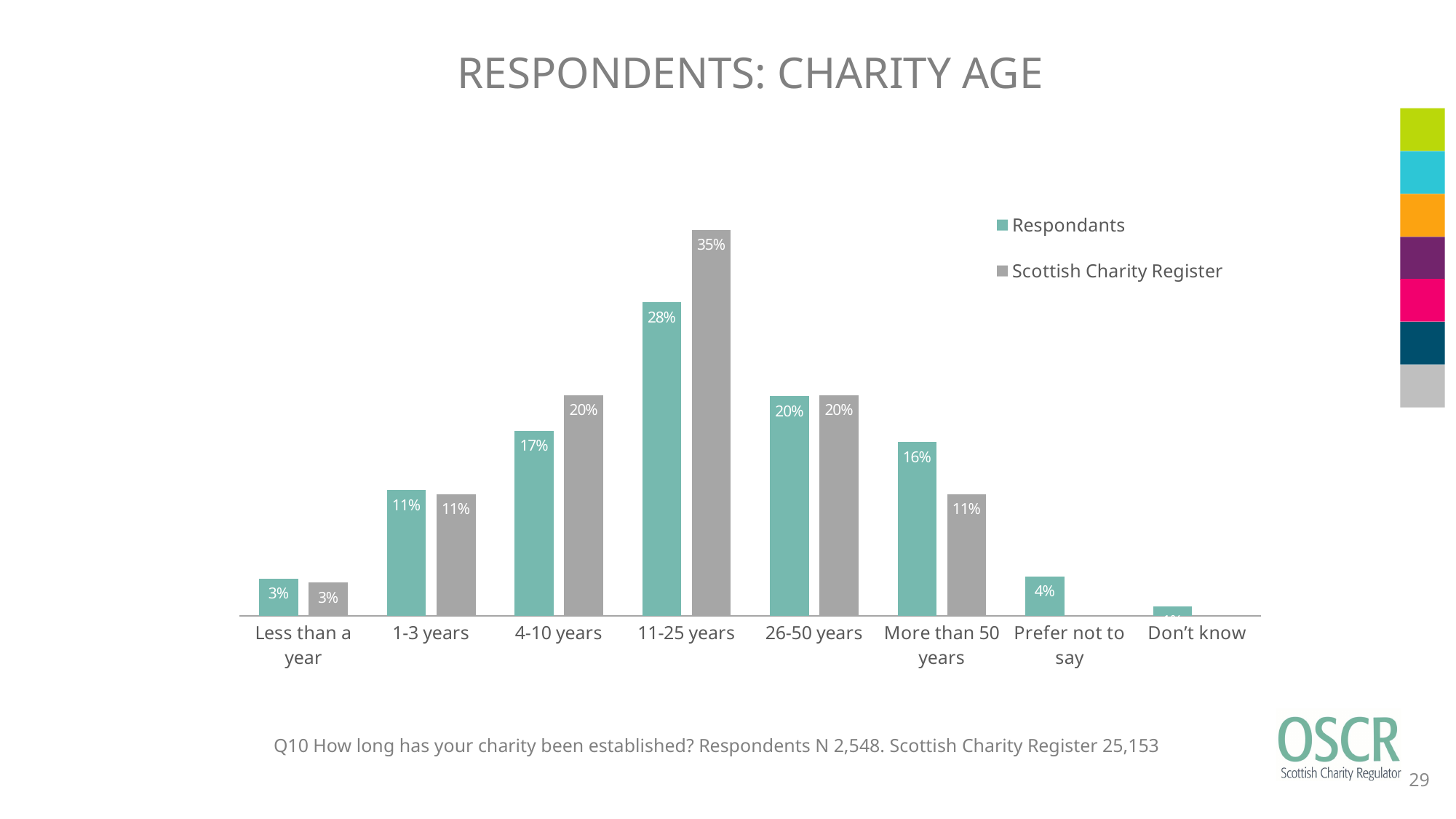
How many series does the legend list? 2 For More than 50 years, which is larger: the Respondants value or the Scottish Charity Register value? Respondants How many categories are shown on the x axis? 8 What is the Scottish Charity Register value for 11-25 years? 35% What kind of chart is shown on the slide? Bar chart Which category has the lowest Scottish Charity Register value? Less than a year What is the Scottish Charity Register value for 4-10 years? 20% What is the Respondants value for More than 50 years? 16% What is the title of the chart? RESPONDENTS: CHARITY AGE Which category has the highest Respondants value? 11-25 years What is the difference between the Scottish Charity Register and Respondants values for 11-25 years? 7% What is the Respondants value for 11-25 years? 28%